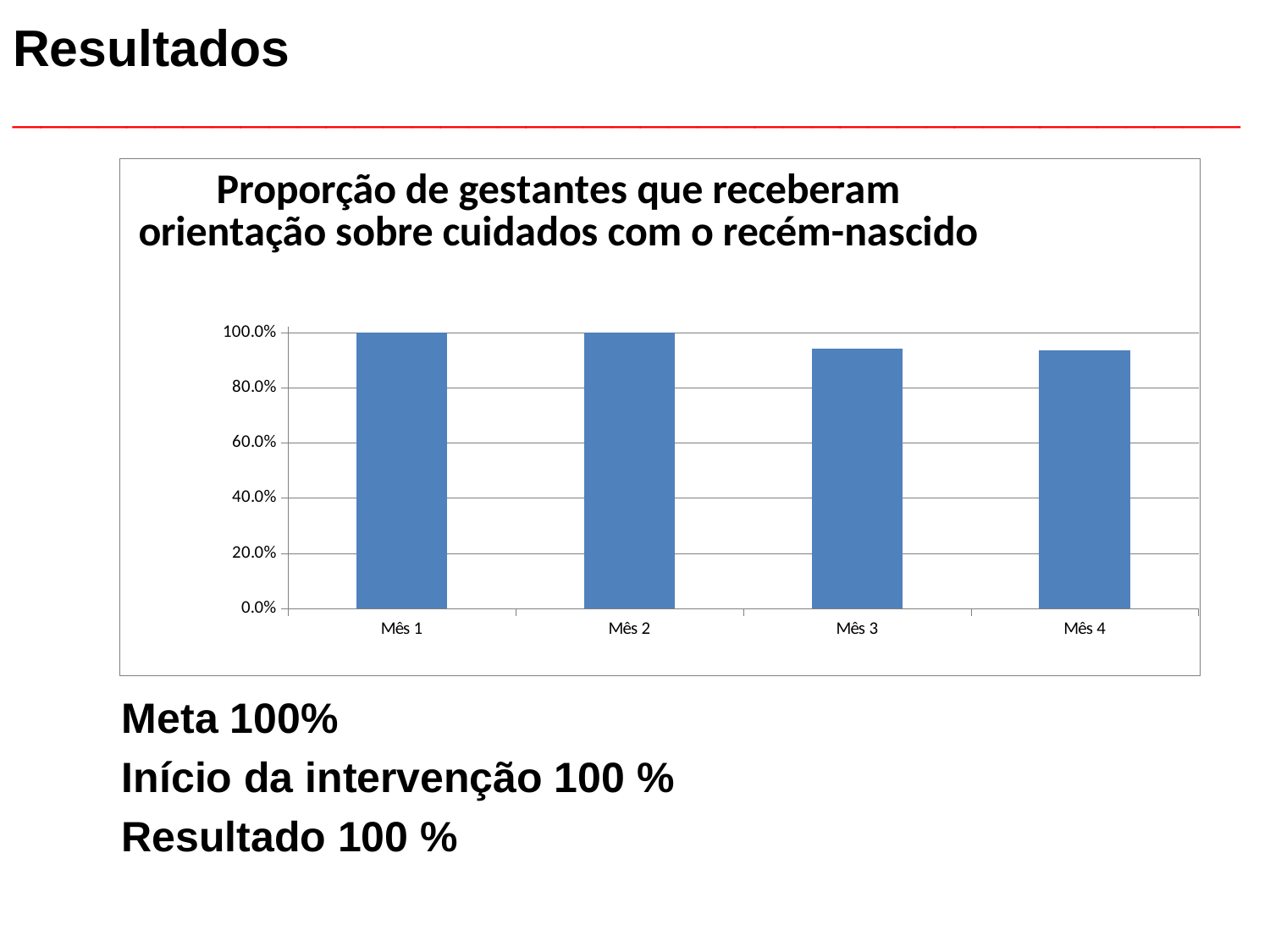
What colour are the bars in the chart? Blue Which is larger, the value for Mês 2 or the value for Mês 4? Mês 2 What is the highest value shown on the y axis of the chart? 100.0% What is the value for Mês 1? 100.0% Do the values rise or fall from Mês 1 to Mês 4? Fall What is the title of the chart? Proporção de gestantes que receberam orientação sobre cuidados com o recém-nascido Is the value for Mês 4 greater or less than 80.0%? greater Which is larger, the value for Mês 1 or the value for Mês 3? Mês 1 What is the value for Mês 2? 100.0% How many months (categories) are shown on the x axis of the chart? 4 What type of chart is shown on the slide? Bar chart Is the value for Mês 3 greater or less than 80.0%? greater